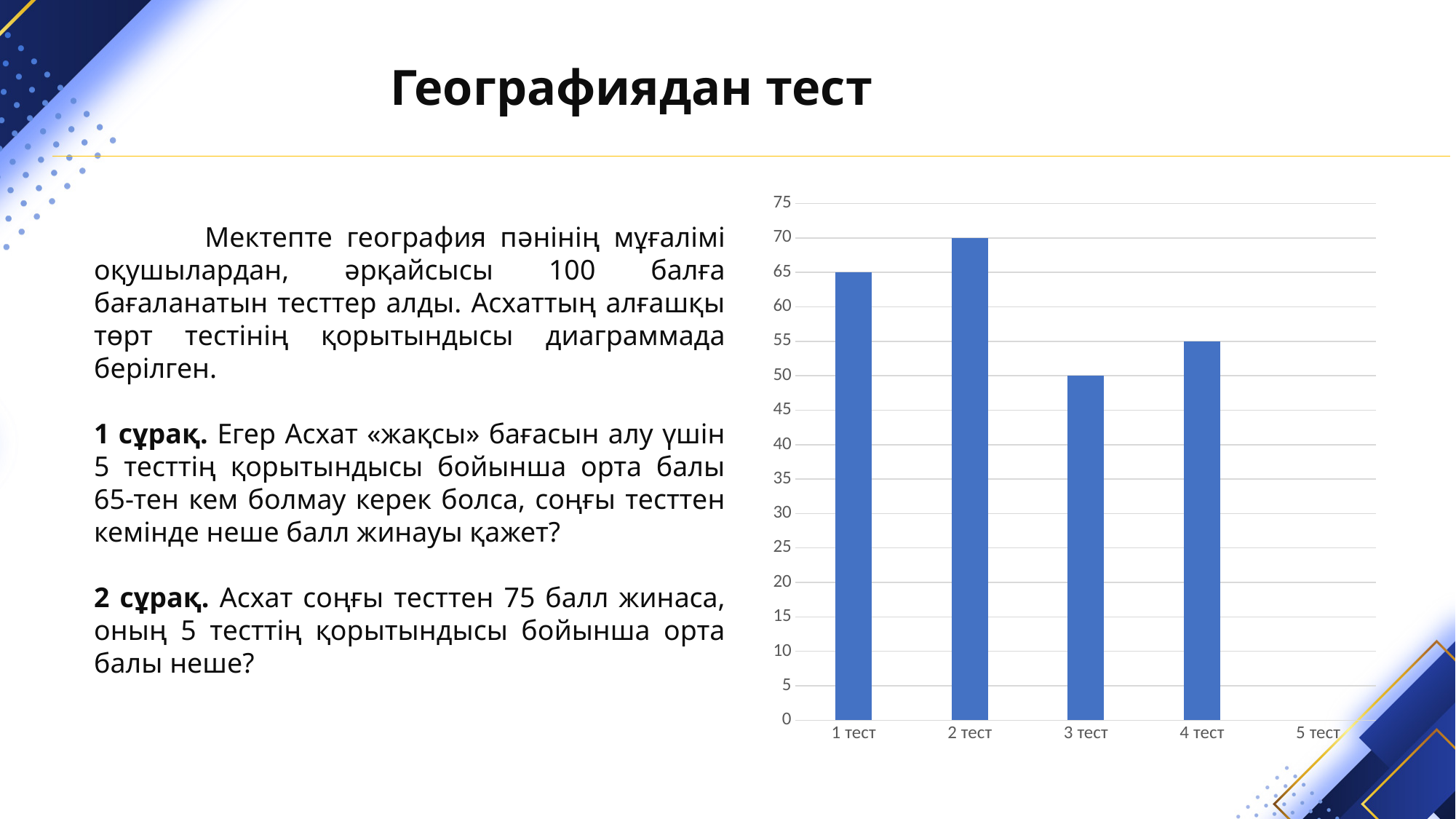
What kind of chart is shown on the slide? bar chart How many bars are plotted on the chart? 4 Which category on the x axis has no bar plotted? 5 тест Which is larger, the value for 1 тест or the value for 4 тест? 1 тест Is the value for 4 тест greater or less than 60? less What is the value for 2 тест? 70 What is the value for 1 тест? 65 Which test has the highest bar? 2 тест What is the value for 4 тест? 55 What is the difference between the values for 2 тест and 3 тест? 20 What is the value for 3 тест? 50 Which test has the lowest bar among those plotted? 3 тест